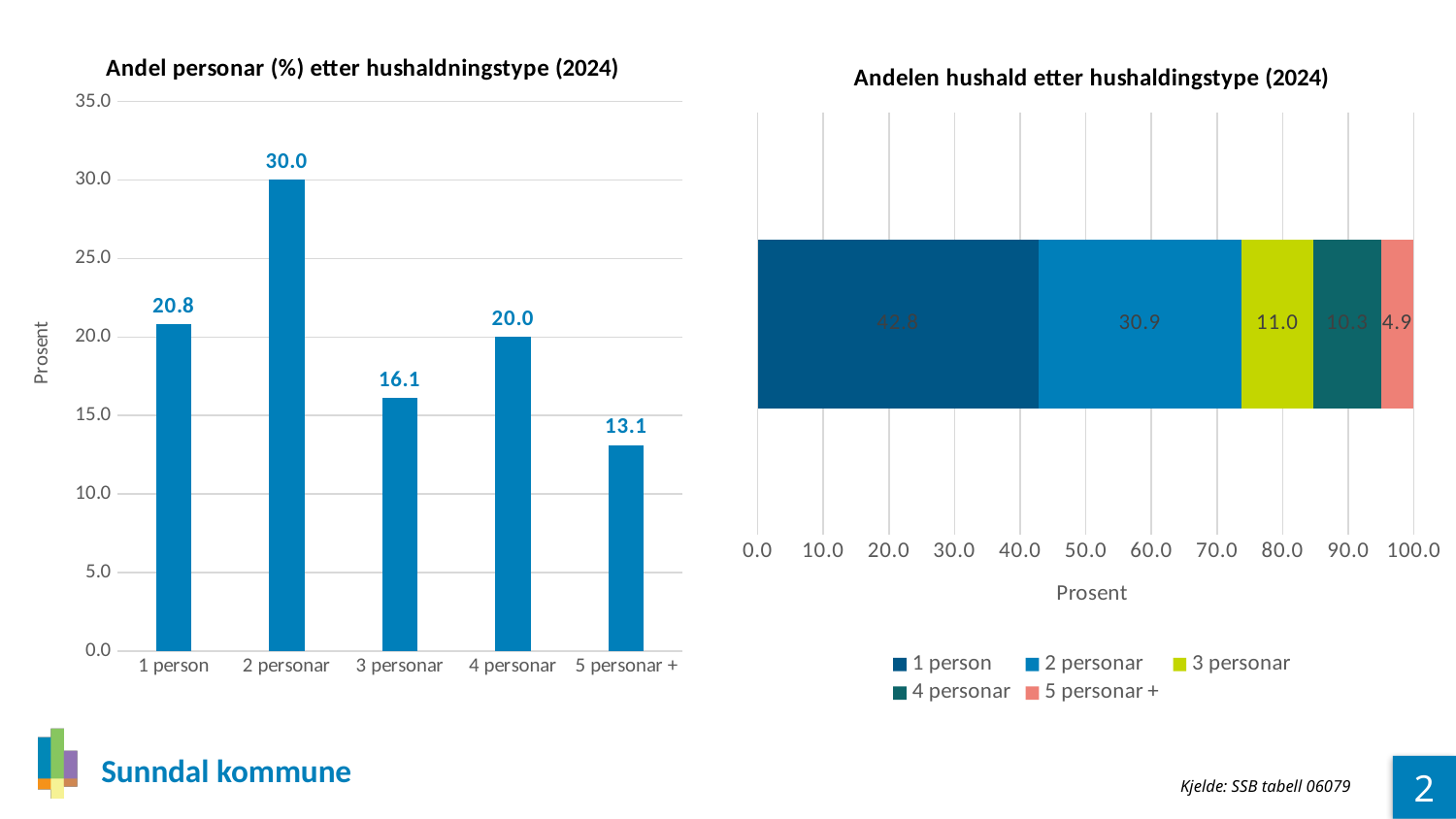
What kind of chart is 'Andel personar (%) etter hushaldningstype (2024)'? bar chart How many categories are shown on the x axis of the chart 'Andel personar (%) etter hushaldningstype (2024)'? 5 In the chart 'Andelen hushald etter hushaldingstype (2024)', what is the value for 5 personar +? 4.9 How many series does the legend of the chart 'Andelen hushald etter hushaldingstype (2024)' list? 5 In the chart 'Andelen hushald etter hushaldingstype (2024)', is the value for 1 person greater or less than 40.0? greater In the chart 'Andel personar (%) etter hushaldningstype (2024)', which household type has the lowest value? 5 personar + In the chart 'Andel personar (%) etter hushaldningstype (2024)', what is the difference between the values for 2 personar and 3 personar? 13.9 In the chart 'Andel personar (%) etter hushaldningstype (2024)', which is larger, the value for 1 person or the value for 4 personar? 1 person In the chart 'Andel personar (%) etter hushaldningstype (2024)', what is the value for 2 personar? 30.0 In the chart 'Andel personar (%) etter hushaldningstype (2024)', which household type has the highest value? 2 personar In the chart 'Andelen hushald etter hushaldingstype (2024)', what is the value for 2 personar? 30.9 In the chart 'Andel personar (%) etter hushaldningstype (2024)', what is the value for 5 personar +? 13.1